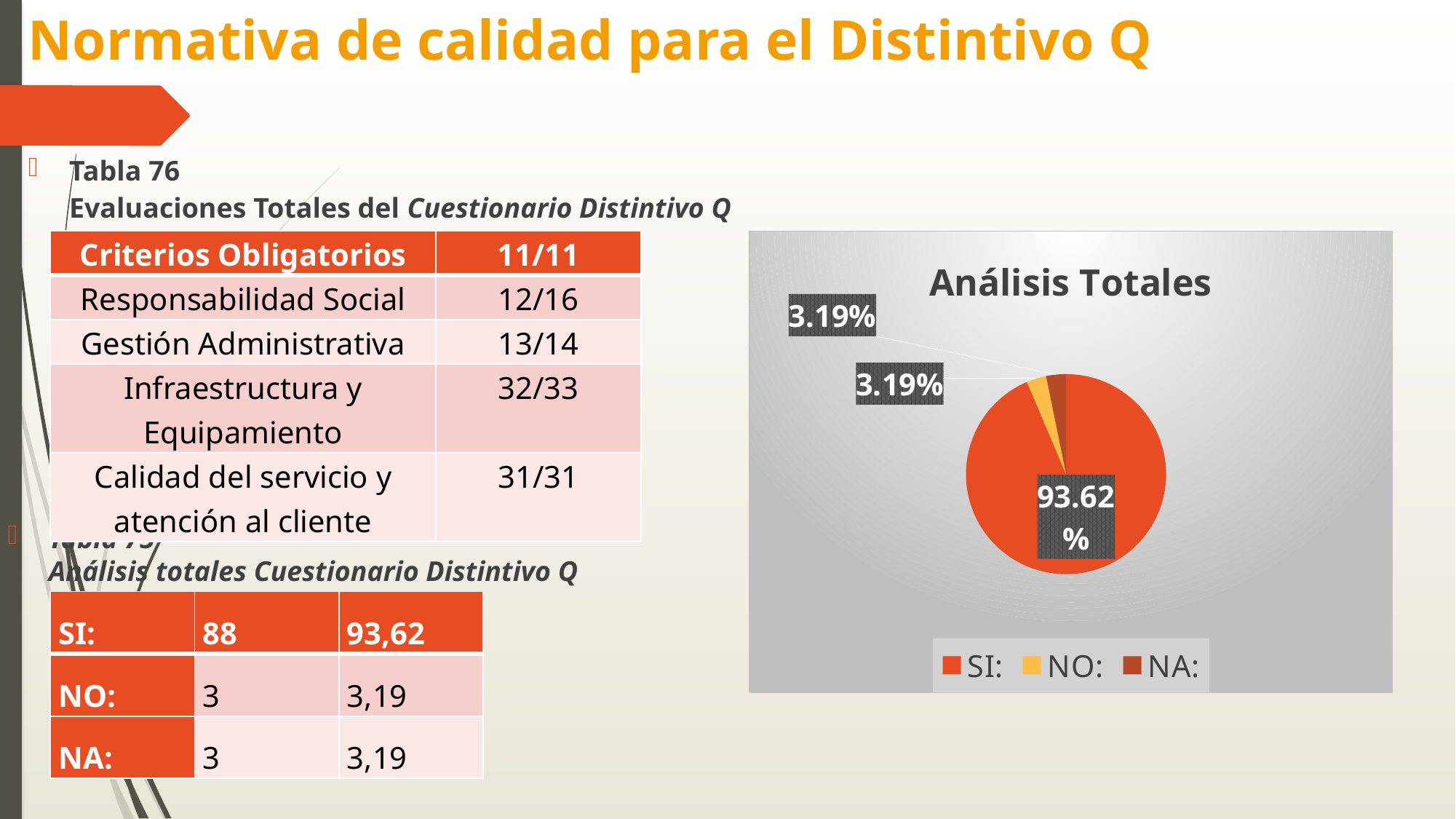
What kind of chart is shown on the slide? pie chart What is the difference in percentage points between the SI: slice and the NO: slice? 90.43 What percentage does the SI: slice show in the pie chart? 93.62% Which legend entry is shown in yellow in the pie chart? NO: Which is larger in the pie chart, SI: or NO:? SI: Which category has the largest slice in the pie chart? SI: How many entries does the chart legend list? 3 What percentage does the NA: slice show in the pie chart? 3.19% What percentage does the NO: slice show in the pie chart? 3.19% What is the title of the chart? Análisis Totales How many slices does the pie chart have? 3 What share of the pie does the SI: slice represent? 93.62%